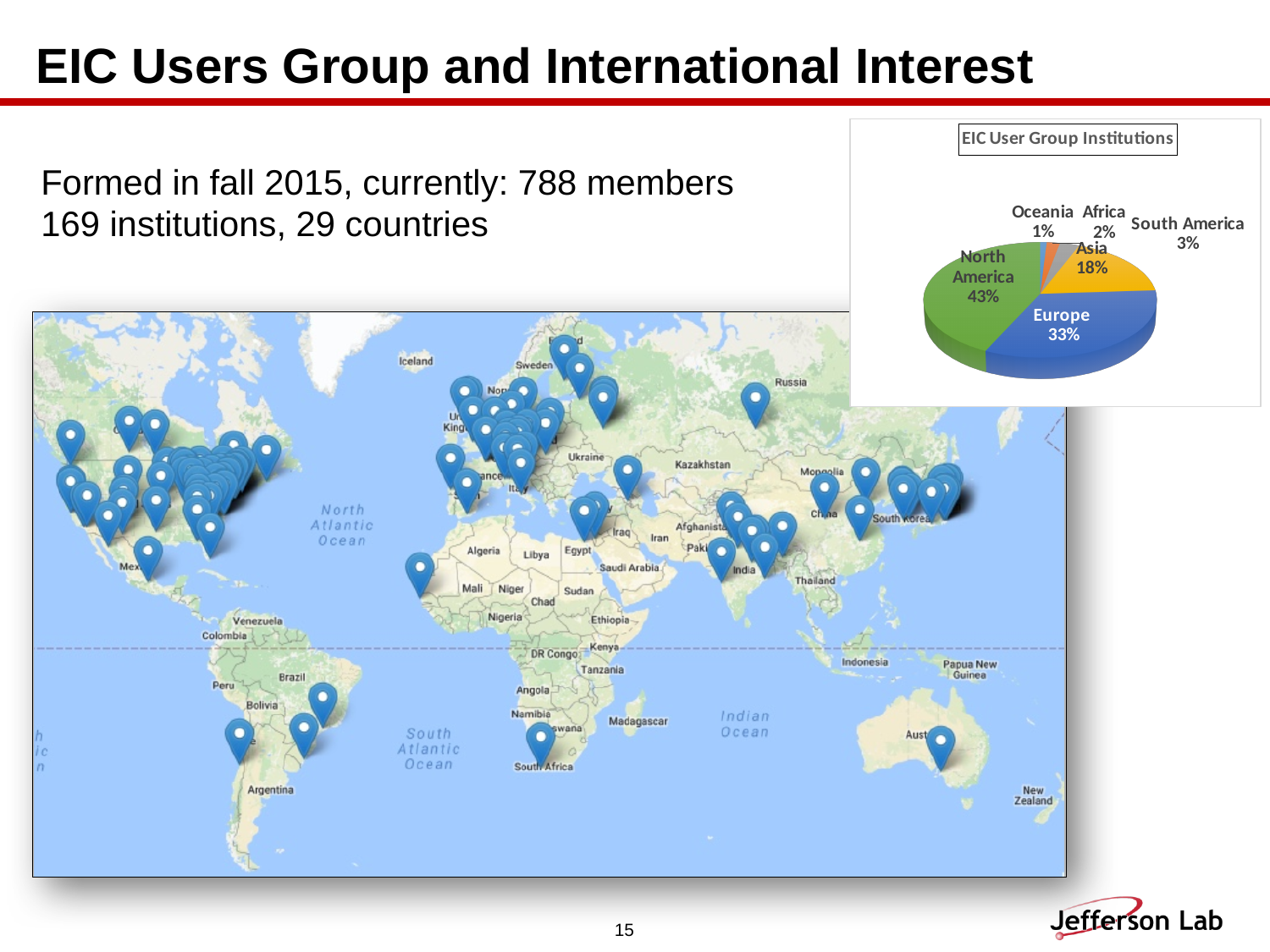
What is the title of the pie chart? EIC User Group Institutions Which region has the smallest share of EIC User Group institutions? Oceania What is the difference in percentage points between the North America and Europe shares? 10% What share of EIC User Group institutions is from North America? 43% What share of EIC User Group institutions is from Europe? 33% Which has a larger share of EIC User Group institutions, Asia or Africa? Asia What share of EIC User Group institutions is from Asia? 18% What share of EIC User Group institutions is from Oceania? 1% How many regions are shown in the EIC User Group Institutions pie chart? 6 What share of EIC User Group institutions is from South America? 3% Which region has the largest share of EIC User Group institutions? North America What kind of chart is shown in the top right of the slide? pie chart